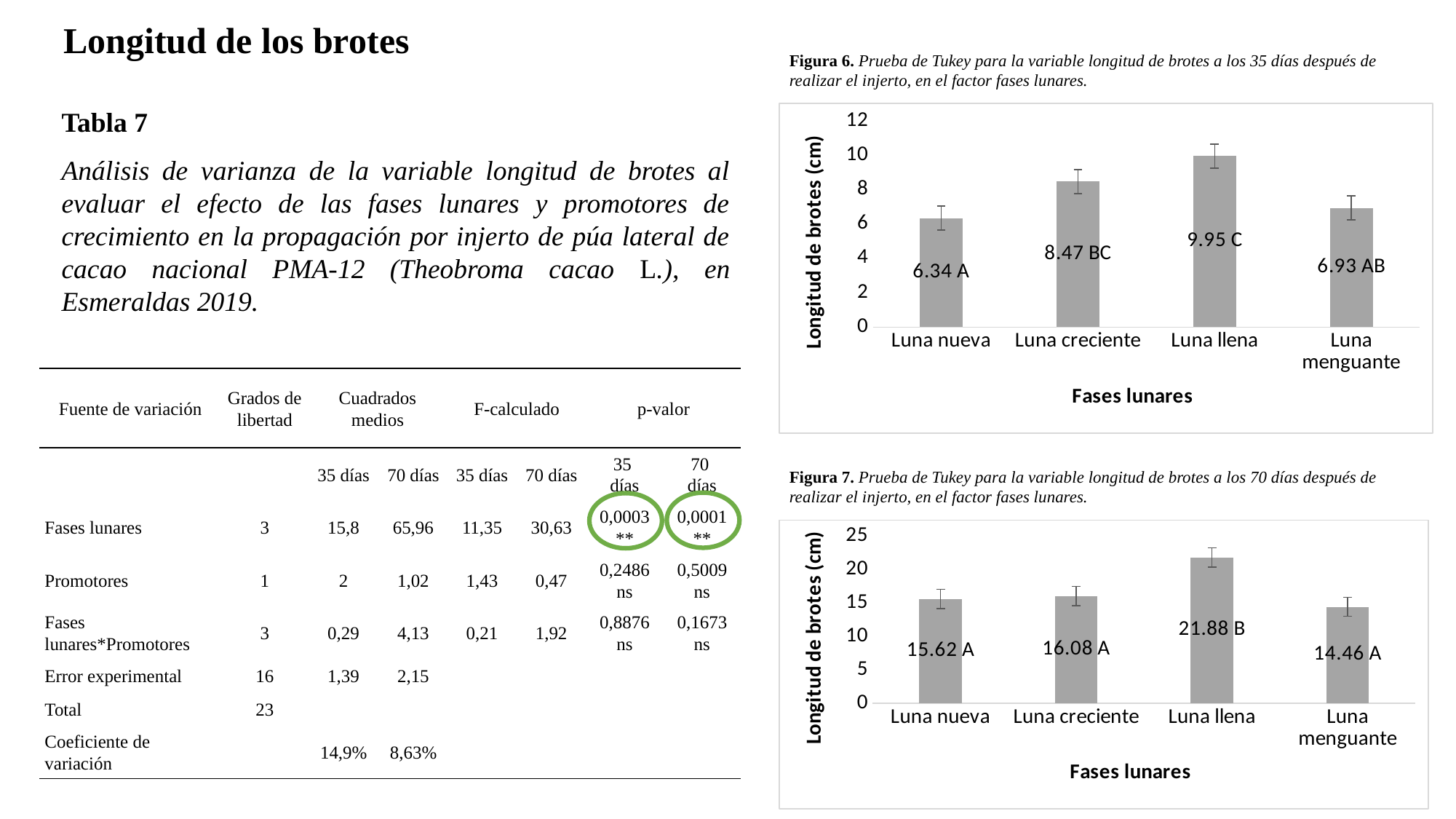
In Figura 7 (70 días), which lunar phase has the highest shoot length? Luna llena In Figura 7 (70 días), what is the difference between the values for Luna llena and Luna menguante? 7.42 In Figura 6 (35 días), what is the value for Luna llena? 9.95 In Figura 7 (70 días), what is the value for Luna creciente? 16.08 In Figura 6 (35 días), which lunar phase has the highest shoot length? Luna llena How many lunar phases are shown on the x axis of Figura 6? 4 What type of chart is Figura 7? Bar chart In Figura 7 (70 días), what is the value for Luna menguante? 14.46 In Figura 7 (70 días), is the value for Luna llena greater or less than 20? greater In Figura 6 (35 días), which lunar phase has the lowest shoot length? Luna nueva In Figura 6 (35 días), what is the value for Luna nueva? 6.34 In Figura 6 (35 días), what is the difference between the values for Luna llena and Luna nueva? 3.61